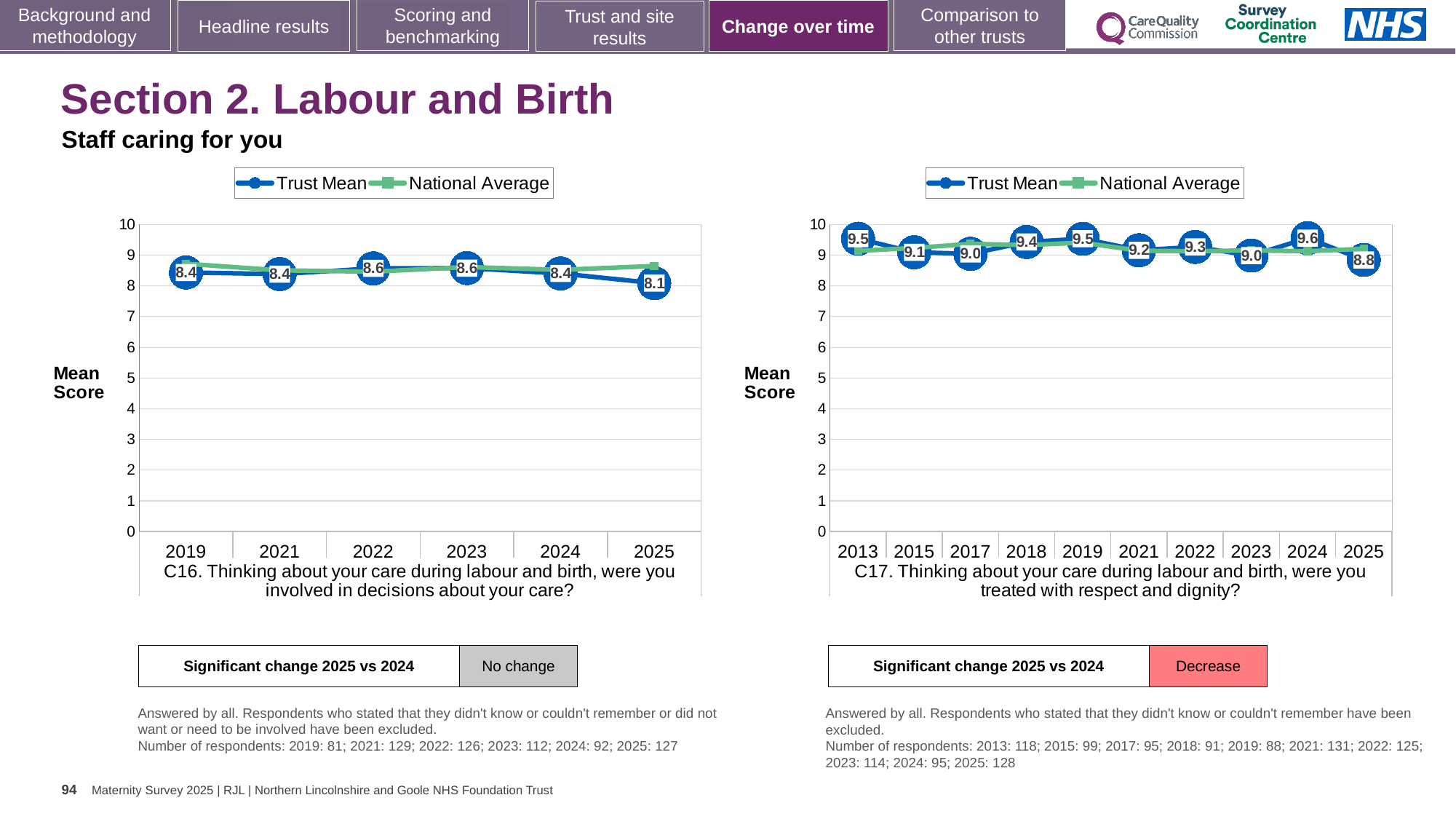
On the C17 chart (right), which year has the highest Trust Mean score? 2024 On the C16 chart (left), what is the difference between the Trust Mean scores for 2023 and 2025? 0.5 On the C16 chart (left), what is the Trust Mean score for 2022? 8.6 On the C16 chart (left), how many years are shown on the x axis? 6 On the C16 chart (left), what is the Trust Mean score for 2025? 8.1 What kind of chart is the C17 chart (right)? Line chart On the C17 chart (right), which year has the lowest Trust Mean score? 2025 On the C16 chart (left), which year has the lowest Trust Mean score? 2025 On the C17 chart (right), what is the Trust Mean score for 2024? 9.6 On the C17 chart (right), which is larger, the Trust Mean score for 2013 or for 2017? 2013 On the C16 chart (left), is the National Average value for 2025 greater or less than 8? greater On the C17 chart (right), how many series does the legend list? 2